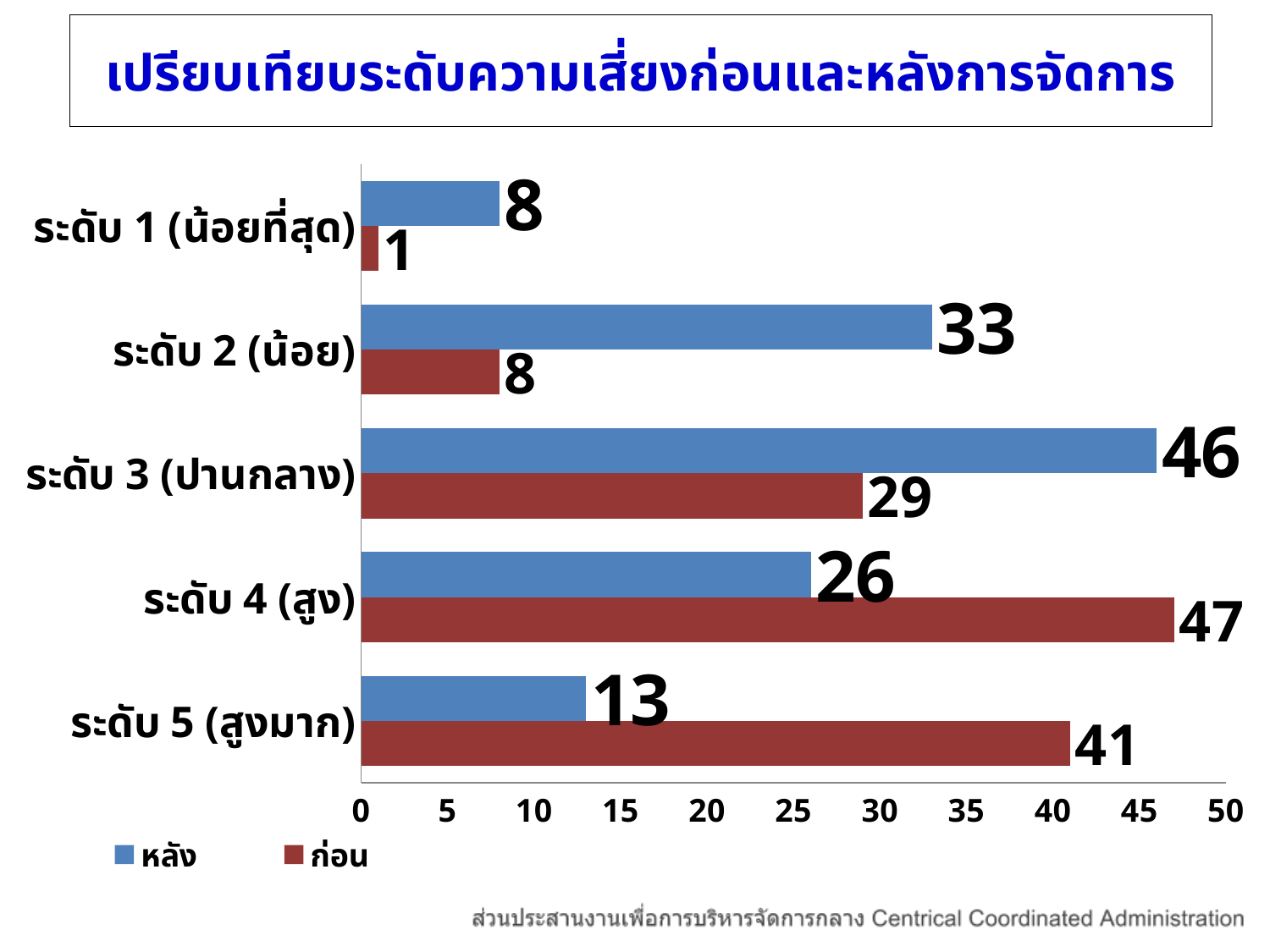
What colour represents the ก่อน series? Red What is the value of หลัง for ระดับ 3 (ปานกลาง)? 46 What is the value of ก่อน for ระดับ 4 (สูง)? 47 What type of chart is shown on the slide? Bar chart For ระดับ 2 (น้อย), which is larger: หลัง or ก่อน? หลัง What is the value of ก่อน for ระดับ 1 (น้อยที่สุด)? 1 How many categories are shown on the chart? 5 How many series does the legend list? 2 What is the difference between the ก่อน and หลัง values for ระดับ 5 (สูงมาก)? 28 Which category has the highest ก่อน value? ระดับ 4 (สูง) Which category has the lowest หลัง value? ระดับ 1 (น้อยที่สุด) What is the value of หลัง for ระดับ 5 (สูงมาก)? 13